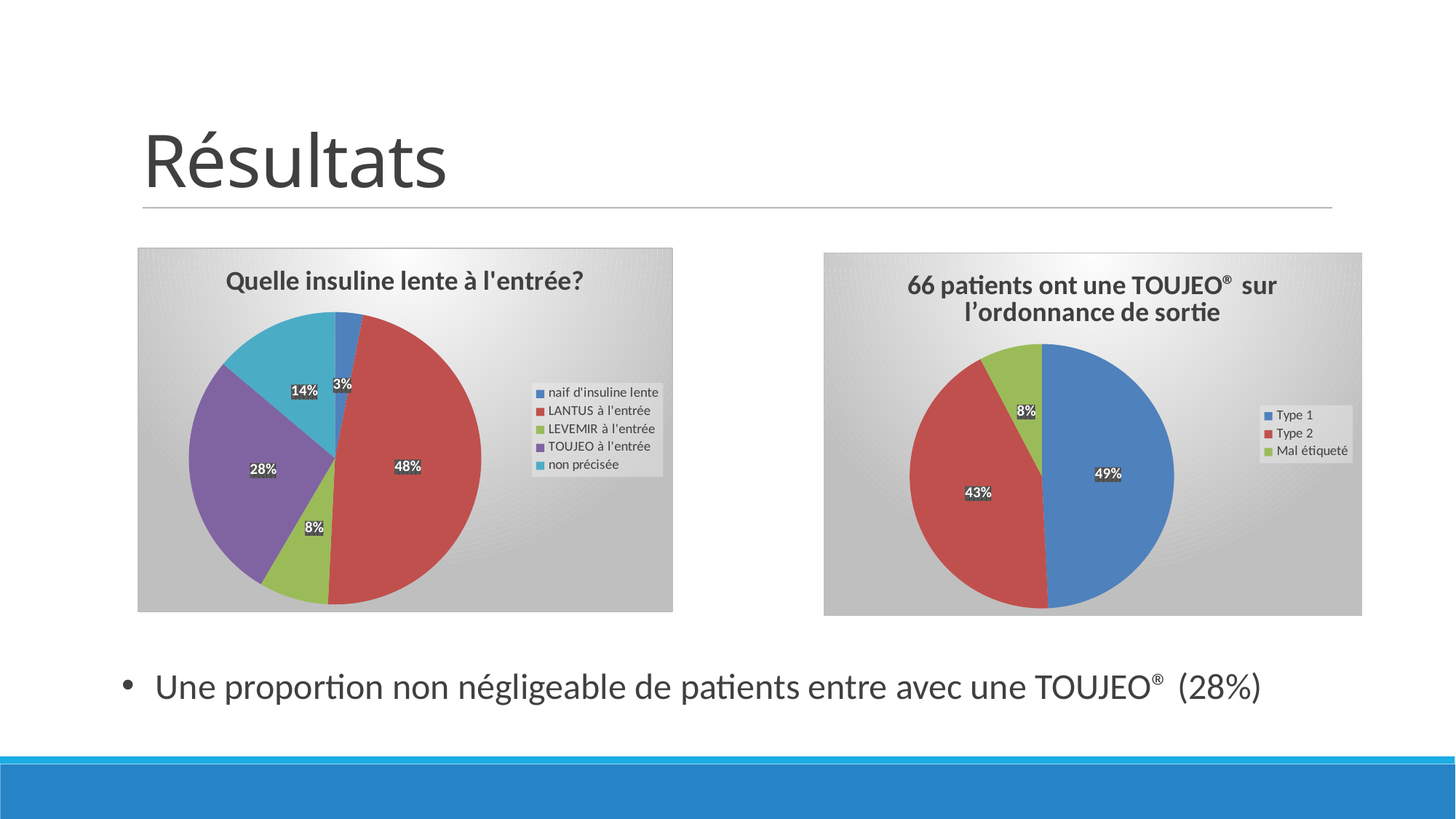
In the chart titled "Quelle insuline lente à l'entrée?", what share is shown for TOUJEO à l'entrée? 28% In the chart titled "Quelle insuline lente à l'entrée?", what share is shown for LANTUS à l'entrée? 48% In the chart titled "Quelle insuline lente à l'entrée?", which category has the largest slice? LANTUS à l'entrée In the chart on the right, "66 patients ont une TOUJEO sur l'ordonnance de sortie", what share is shown for Mal étiqueté? 8% In the chart on the right, "66 patients ont une TOUJEO sur l'ordonnance de sortie", which is larger, Type 1 or Type 2? Type 1 What kind of chart is the chart on the right, "66 patients ont une TOUJEO sur l'ordonnance de sortie"? Pie chart In the chart on the right, "66 patients ont une TOUJEO sur l'ordonnance de sortie", which category has the largest slice? Type 1 In the chart titled "Quelle insuline lente à l'entrée?", what share is shown for non précisée? 14% In the chart on the right, "66 patients ont une TOUJEO sur l'ordonnance de sortie", what share is shown for Type 2? 43% In the chart titled "Quelle insuline lente à l'entrée?", what is the difference in percentage points between LANTUS à l'entrée and TOUJEO à l'entrée? 20 In the chart titled "Quelle insuline lente à l'entrée?", which category has the smallest slice? naif d'insuline lente In the chart titled "Quelle insuline lente à l'entrée?", how many categories does the legend list? 5